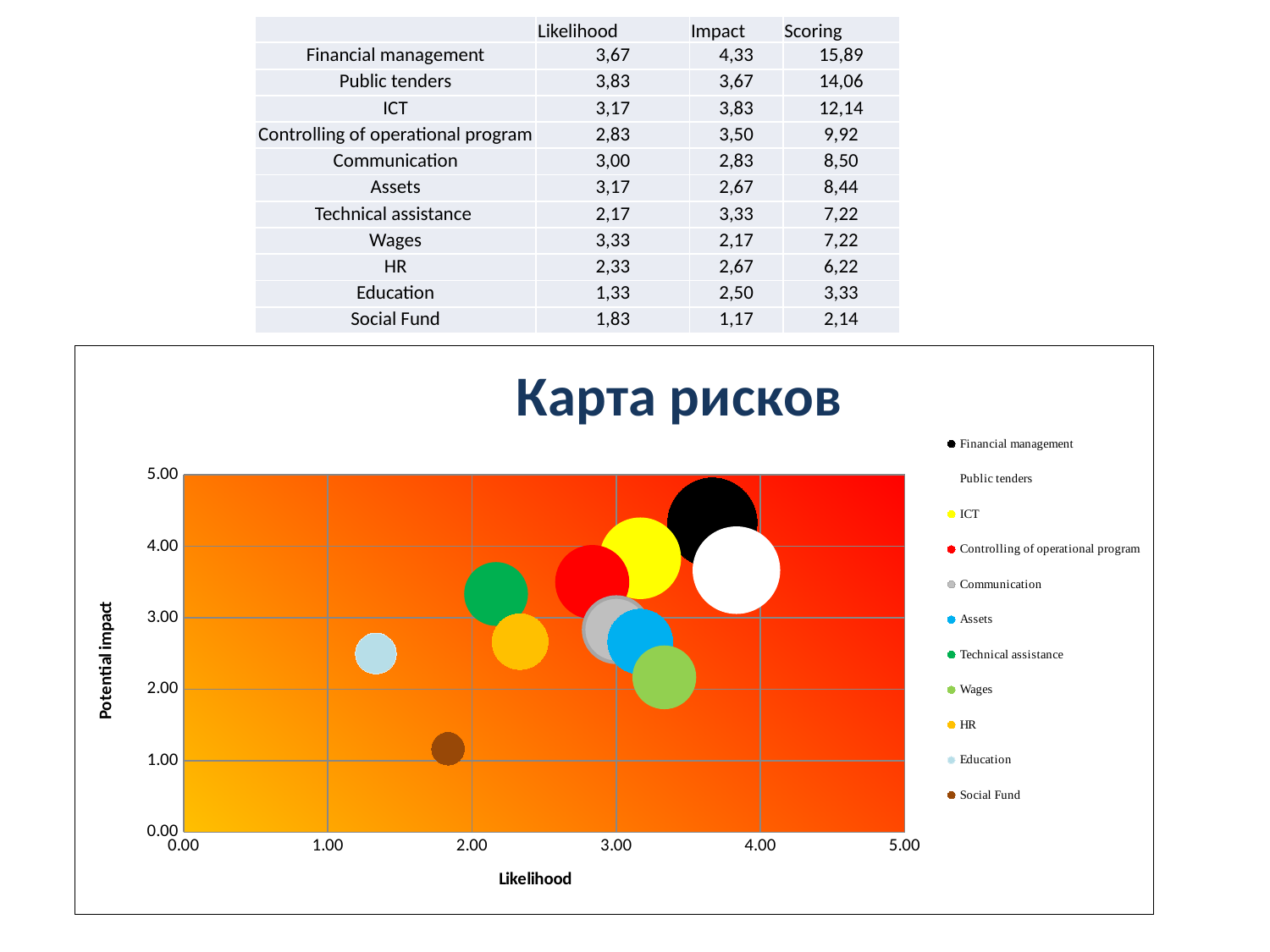
Which series has the lowest Potential impact in the chart? Social Fund What is the title of the chart? Карта рисков Is the Likelihood for Public tenders greater or less than 3.00? greater Which has the higher Potential impact, Assets or Wages? Assets According to the table, what is the Likelihood value for Financial management? 3,67 Which series has the lowest Likelihood in the chart? Education Is the Potential impact for Social Fund greater or less than 2.00? less How many series does the chart legend list? 11 Is the Potential impact for Financial management greater or less than 4.00? greater Which series has the highest Potential impact in the chart? Financial management What kind of chart is shown on the slide? bubble chart What is the label of the x axis of the chart? Likelihood